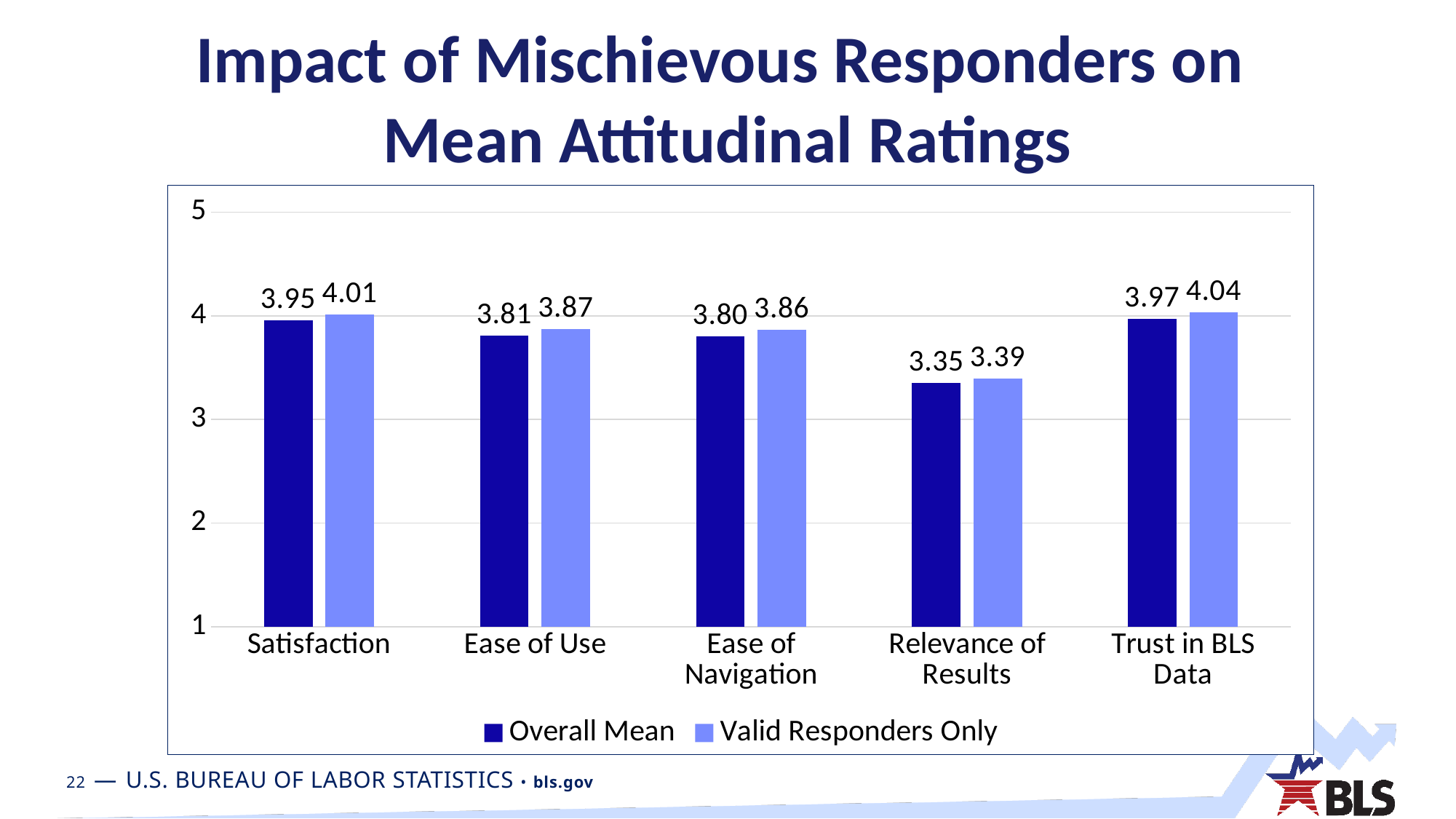
What is the title of the chart? Impact of Mischievous Responders on Mean Attitudinal Ratings What is the Overall Mean value for Satisfaction? 3.95 What is the Valid Responders Only value for Trust in BLS Data? 4.04 Which category has the lowest Overall Mean value? Relevance of Results What kind of chart is shown on the slide? Bar chart How many series does the legend list? 2 Which category has the highest Valid Responders Only value? Trust in BLS Data How many categories are shown on the x axis? 5 Which is larger for Ease of Use: the Overall Mean or the Valid Responders Only value? Valid Responders Only What is the Overall Mean value for Relevance of Results? 3.35 What is the difference between the Valid Responders Only and Overall Mean values for Satisfaction? 0.06 What is the Valid Responders Only value for Ease of Navigation? 3.86